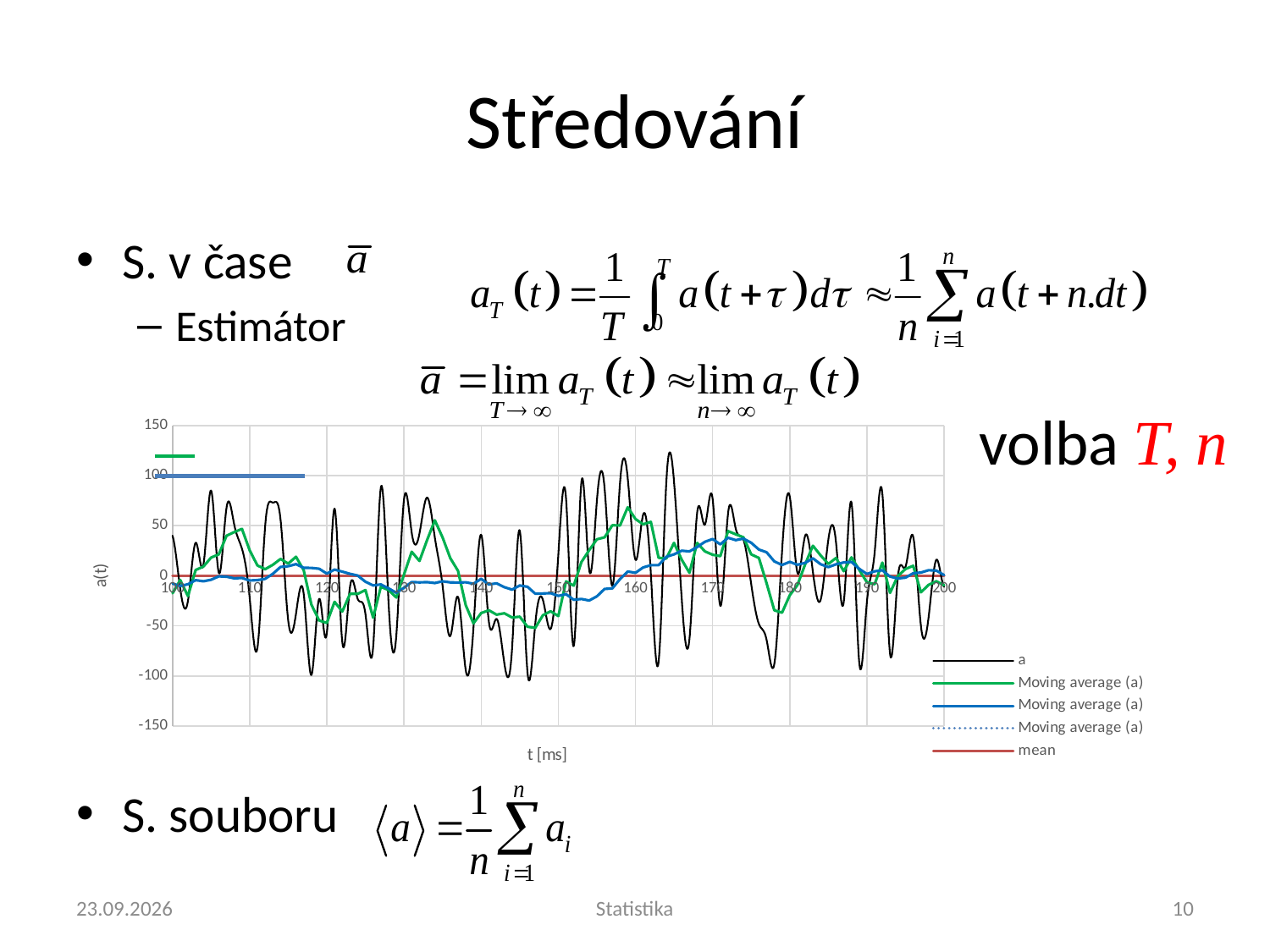
What is the lowest value shown on the y axis of the chart? -150 What is the highest value shown on the y axis of the chart? 150 Is the value of the 'mean' series greater or less than 50? less How many series does the chart legend list? 5 What is the label of the x axis of the chart? t [ms] Is the highest point of the green 'Moving average (a)' series greater or less than 100? less Is the lowest point of the series 'a' greater or less than -50? less What is the label of the y axis of the chart? a(t) What is the first tick value on the x axis of the chart? 100 What kind of chart is shown on the slide? line chart What is the last tick value on the x axis of the chart? 200